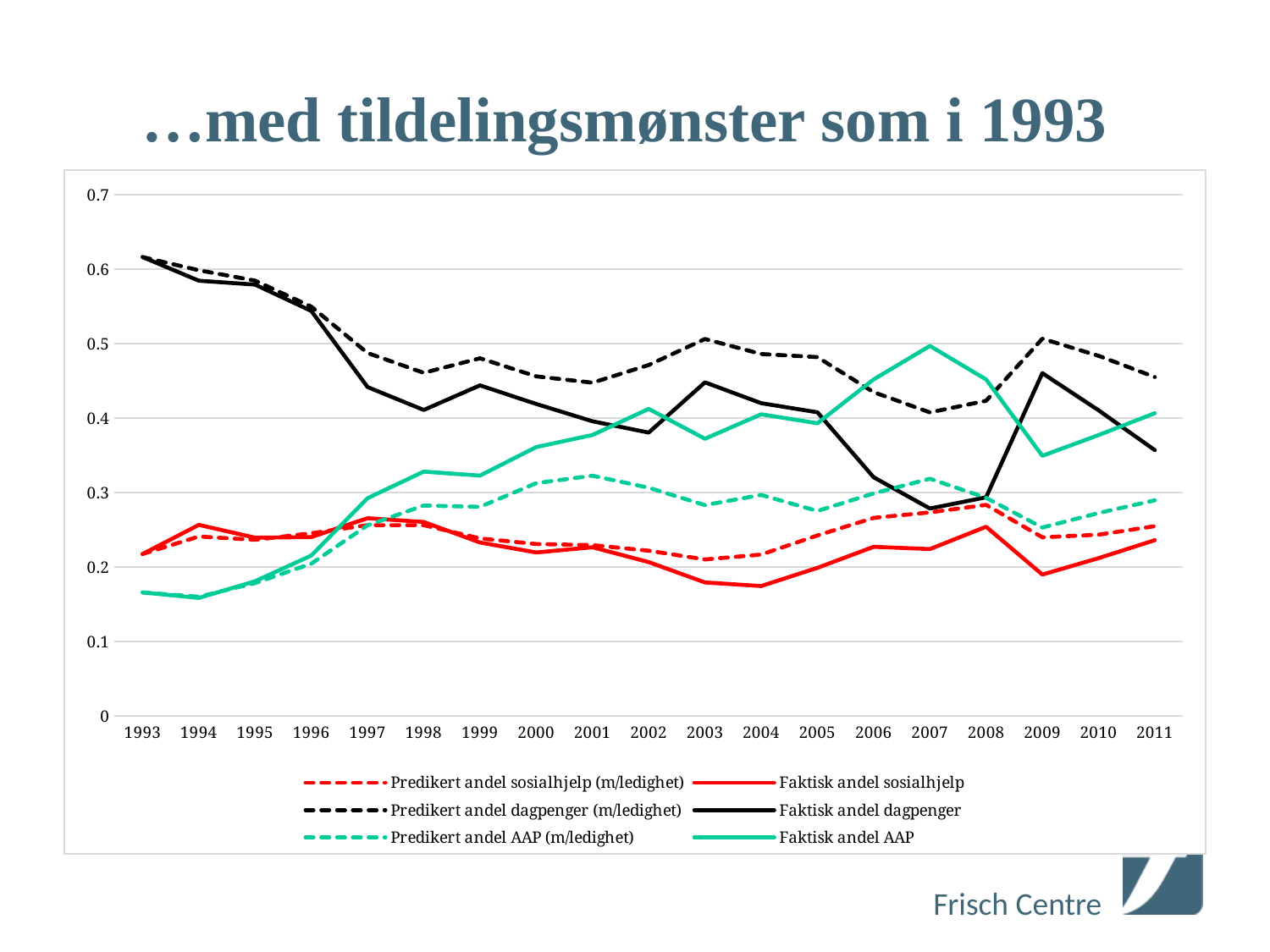
What kind of chart is shown on the slide? line chart In which year does Faktisk andel AAP reach its highest value? 2007 Is the value for Faktisk andel sosialhjelp in 2004 greater or less than 0.2? less How many series does the legend list? 6 Is the value for Faktisk andel dagpenger in 1993 greater or less than 0.5? greater How many years are shown along the x axis? 19 Is the value for Faktisk andel AAP in 1993 greater or less than 0.2? less In 1993, which is larger: Faktisk andel dagpenger or Faktisk andel sosialhjelp? Faktisk andel dagpenger What is the title of the slide? …med tildelingsmønster som i 1993 Does Faktisk andel dagpenger rise or fall overall from 1993 to 2011? fall In 2011, which is larger: Faktisk andel AAP or Faktisk andel dagpenger? Faktisk andel AAP